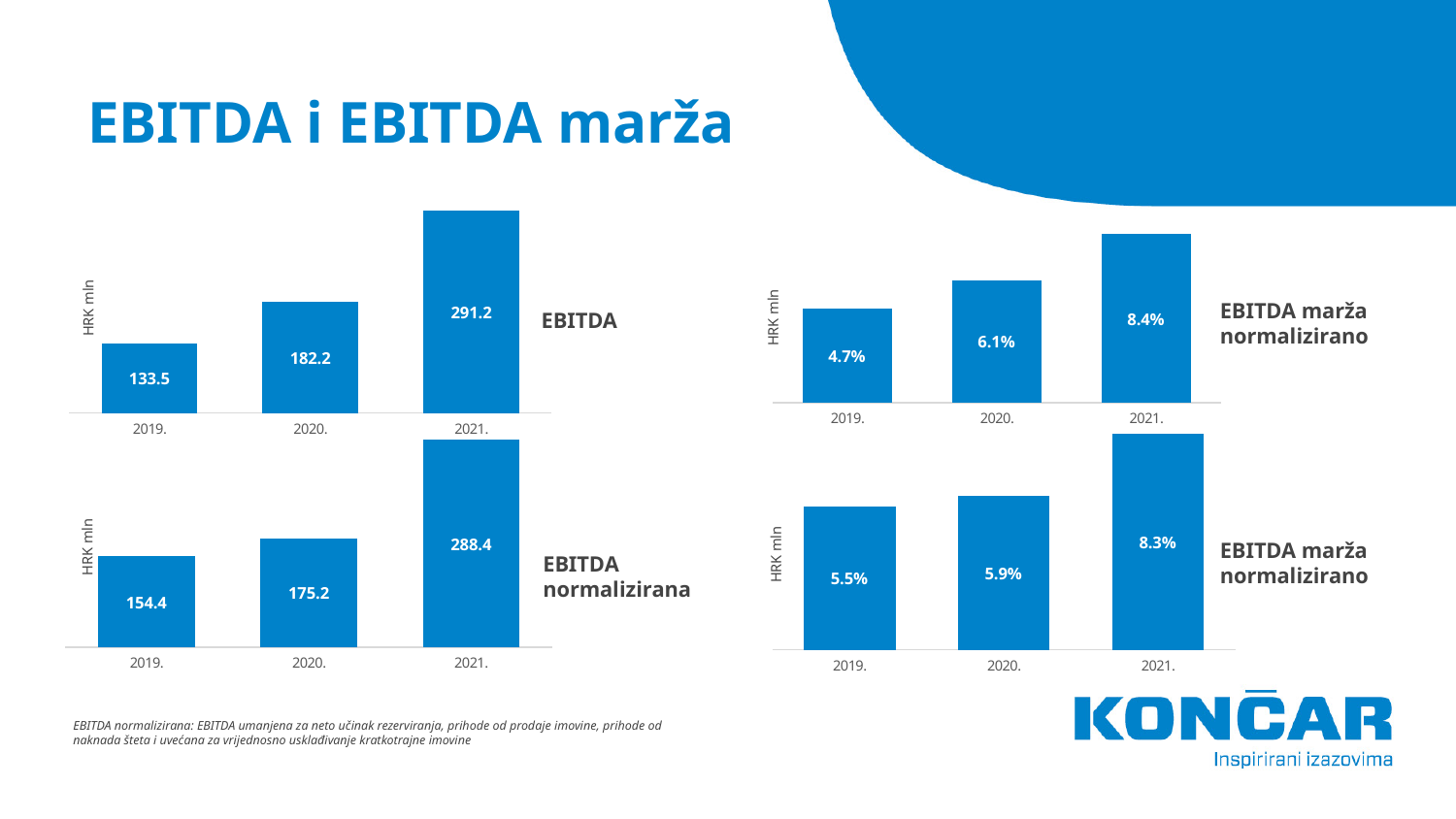
In the EBITDA chart (top left), what is the value for 2019.? 133.5 In the bottom-right EBITDA marža normalizirano chart, what is the value for 2019.? 5.5% In the top-right EBITDA marža normalizirano chart, what is the value for 2020.? 6.1% How many years are shown in the EBITDA chart (top left)? 3 In the EBITDA normalizirana chart (bottom left), which year has the lowest value? 2019. In the EBITDA normalizirana chart (bottom left), what is the value for 2020.? 175.2 In the EBITDA chart (top left), what is the difference between the 2021. and 2020. values? 109.0 In the EBITDA chart (top left), which year has the highest value? 2021. What type of chart is the top-right EBITDA marža normalizirano chart? Bar chart In the bottom-right EBITDA marža normalizirano chart, what is the difference between the 2021. and 2019. values? 2.8% In the EBITDA normalizirana chart (bottom left), which is larger: the value for 2019. or the value for 2020.? 2020. In the EBITDA chart (top left), what is the value for 2021.? 291.2